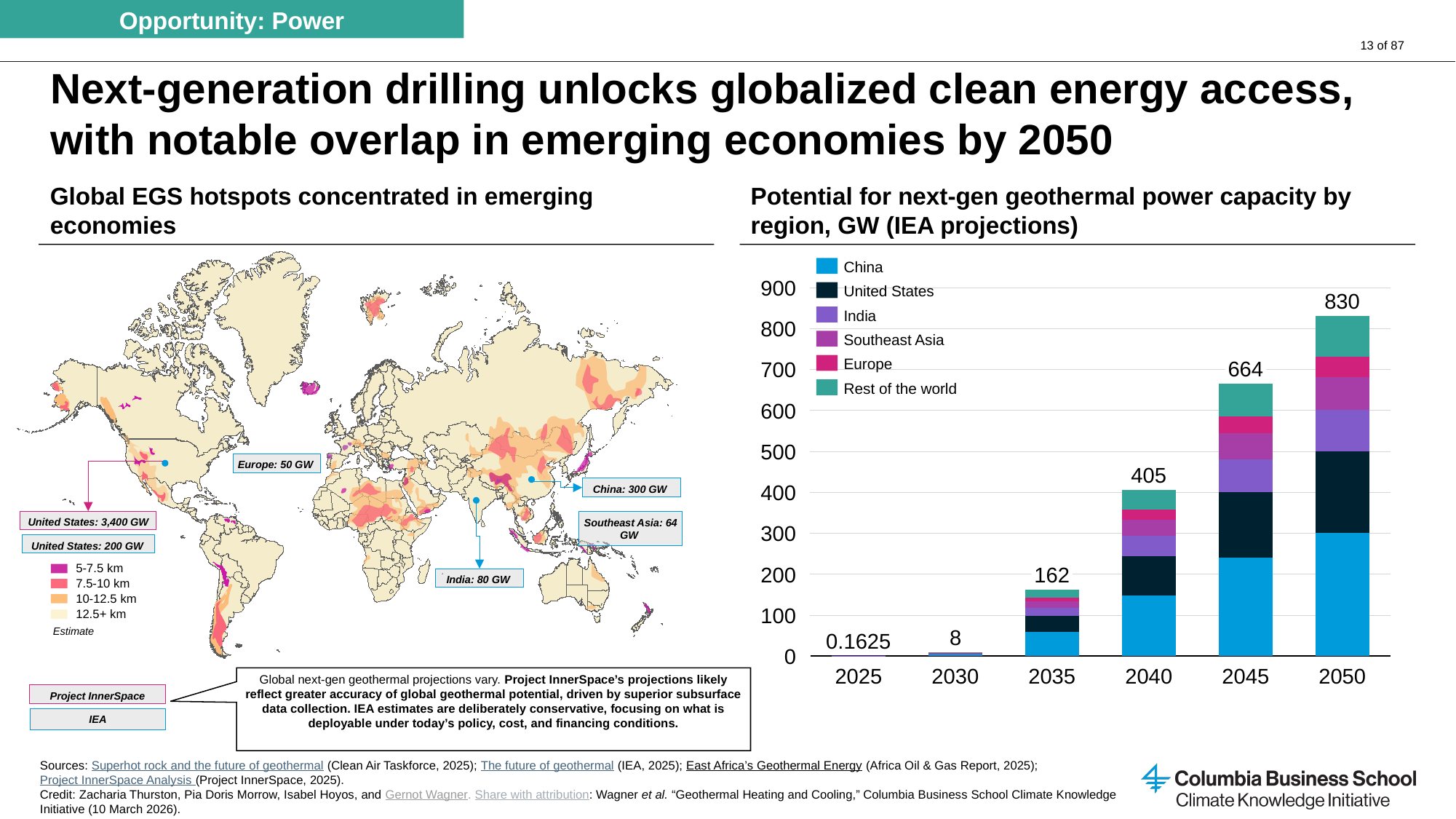
In the chart 'Potential for next-gen geothermal power capacity by region, GW (IEA projections)', what is the total capacity shown for 2040? 405 In the chart 'Potential for next-gen geothermal power capacity by region, GW (IEA projections)', which total is larger, 2035 or 2040? 2040 In the chart 'Potential for next-gen geothermal power capacity by region, GW (IEA projections)', how many regions does the legend list? 6 In the chart 'Potential for next-gen geothermal power capacity by region, GW (IEA projections)', which year has the highest total capacity? 2050 In the chart 'Potential for next-gen geothermal power capacity by region, GW (IEA projections)', what is the total capacity shown for 2050? 830 What kind of chart is 'Potential for next-gen geothermal power capacity by region, GW (IEA projections)'? Stacked bar chart In the chart 'Potential for next-gen geothermal power capacity by region, GW (IEA projections)', is the China segment for 2040 greater or less than 200? less In the chart 'Potential for next-gen geothermal power capacity by region, GW (IEA projections)', how many years are shown on the x axis? 6 In the chart 'Potential for next-gen geothermal power capacity by region, GW (IEA projections)', what is the total capacity shown for 2025? 0.1625 In the chart 'Potential for next-gen geothermal power capacity by region, GW (IEA projections)', do the total values rise or fall from 2025 to 2050? Rise In the chart 'Potential for next-gen geothermal power capacity by region, GW (IEA projections)', what is the difference between the 2050 total and the 2045 total? 166 In the chart 'Potential for next-gen geothermal power capacity by region, GW (IEA projections)', which year has the lowest total capacity? 2025